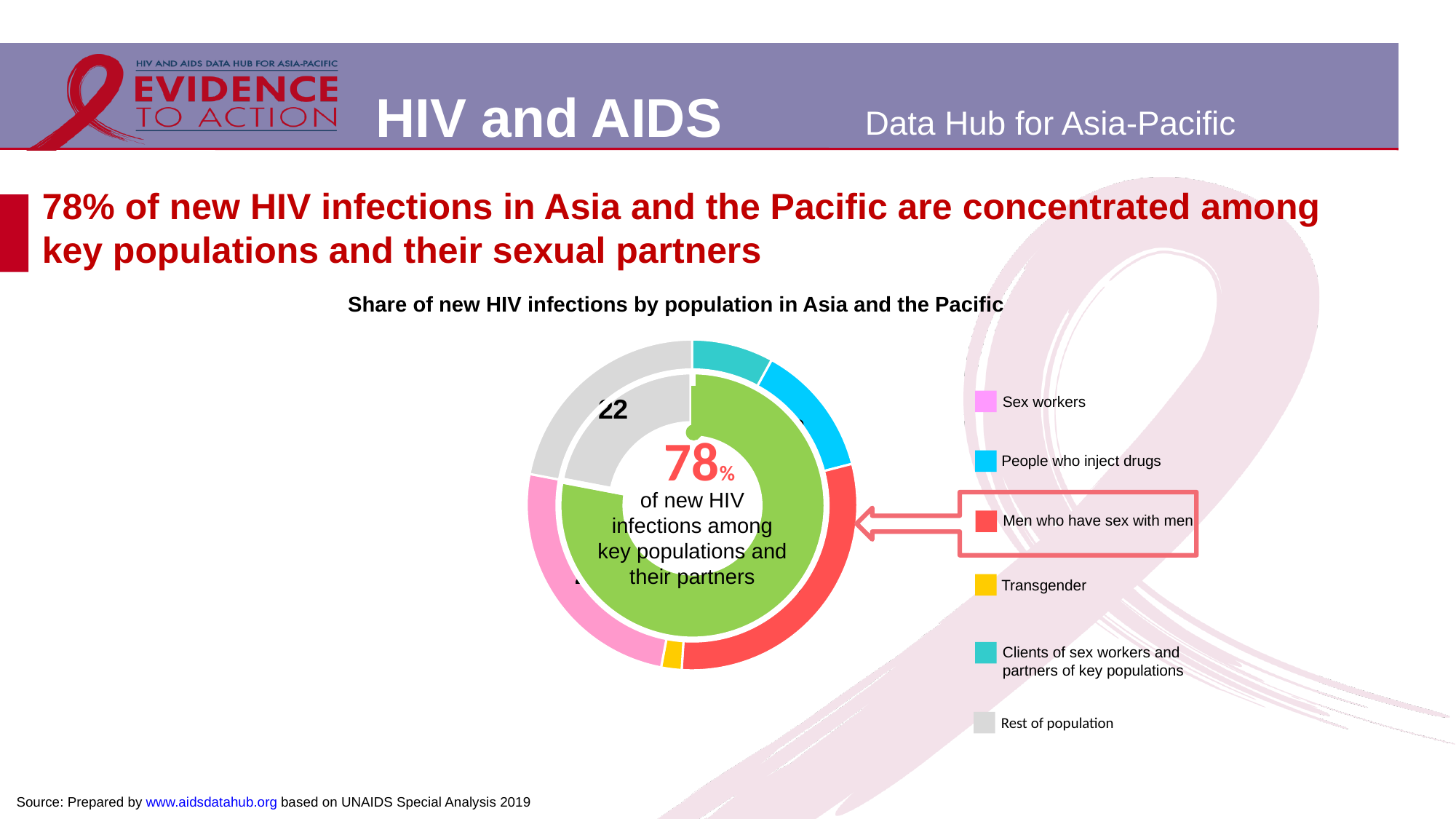
Which has the larger share: Sex workers or Transgender? Sex workers What is the title of the chart? Share of new HIV infections by population in Asia and the Pacific What value is shown for Rest of population in the chart? 22 What kind of chart is shown on the slide? Doughnut (pie) chart How many population groups does the legend list? 6 Which has the larger share: Rest of population or People who inject drugs? Rest of population What percentage of new HIV infections is shown in the centre of the chart as being among key populations and their partners? 78% Which population group has the largest share of new HIV infections in the chart? Men who have sex with men Which legend entry is highlighted with a box and arrow pointing to the chart? Men who have sex with men Which population group has the smallest share of new HIV infections in the chart? Transgender Which colour represents Men who have sex with men in the chart? Red Which has the larger share: Men who have sex with men or Transgender? Men who have sex with men